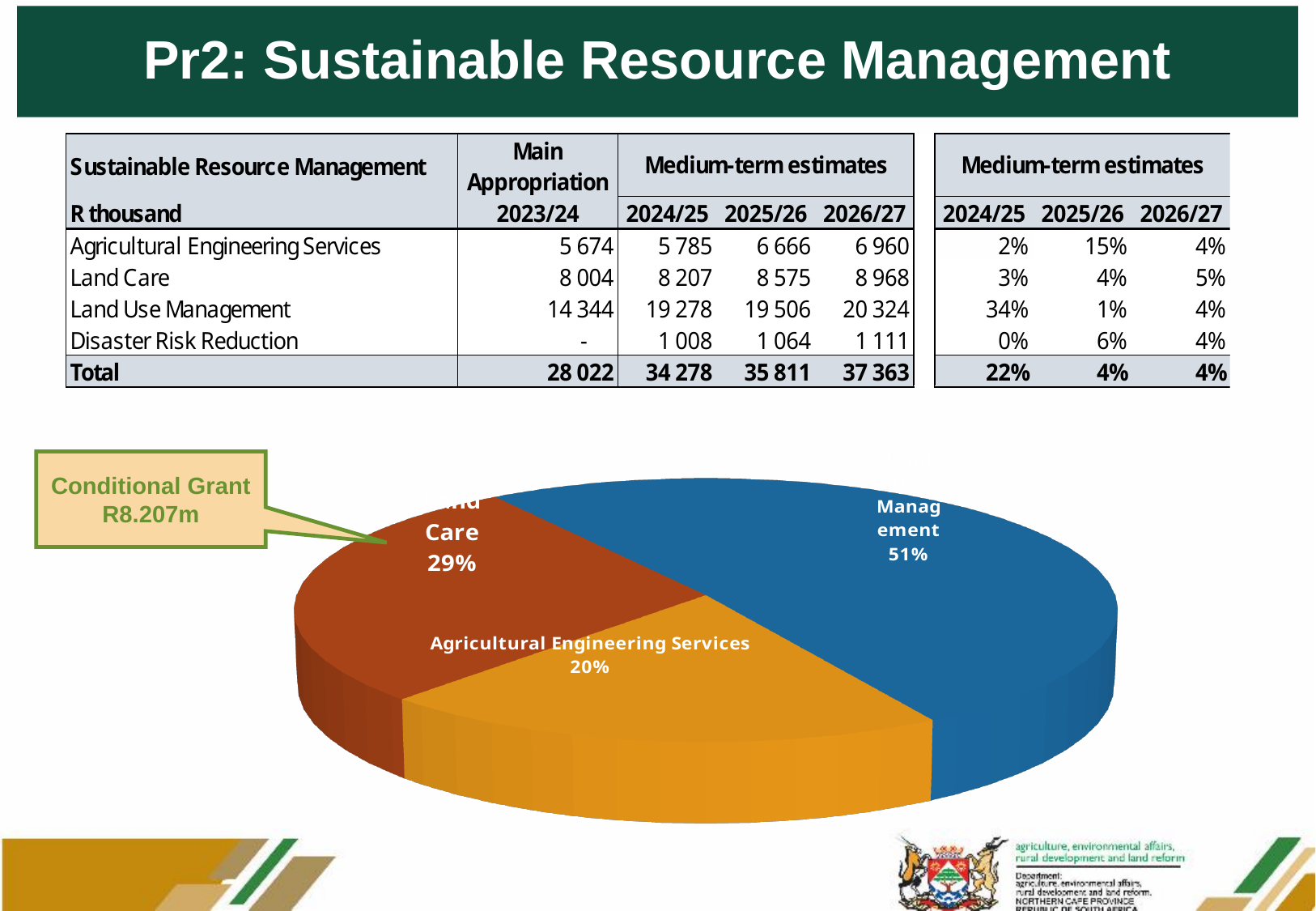
What colour is the Land Use Management slice in the pie chart? blue What is the difference in percentage points between the Land Care slice and the Agricultural Engineering Services slice? 9 What share of the pie chart does Land Care represent? 29% What type of chart is shown on the slide? pie chart What share of the pie chart does Land Use Management represent? 51% What amount does the callout box pointing to the Land Care slice state for the Conditional Grant? R8.207m Which slice of the pie chart is the smallest? Agricultural Engineering Services What share of the pie chart does Agricultural Engineering Services represent? 20% How many slices does the pie chart have? 3 What is the difference in percentage points between the Land Use Management slice and the Land Care slice? 22 Which is larger in the pie chart, Land Care or Agricultural Engineering Services? Land Care Which slice of the pie chart is the largest? Land Use Management